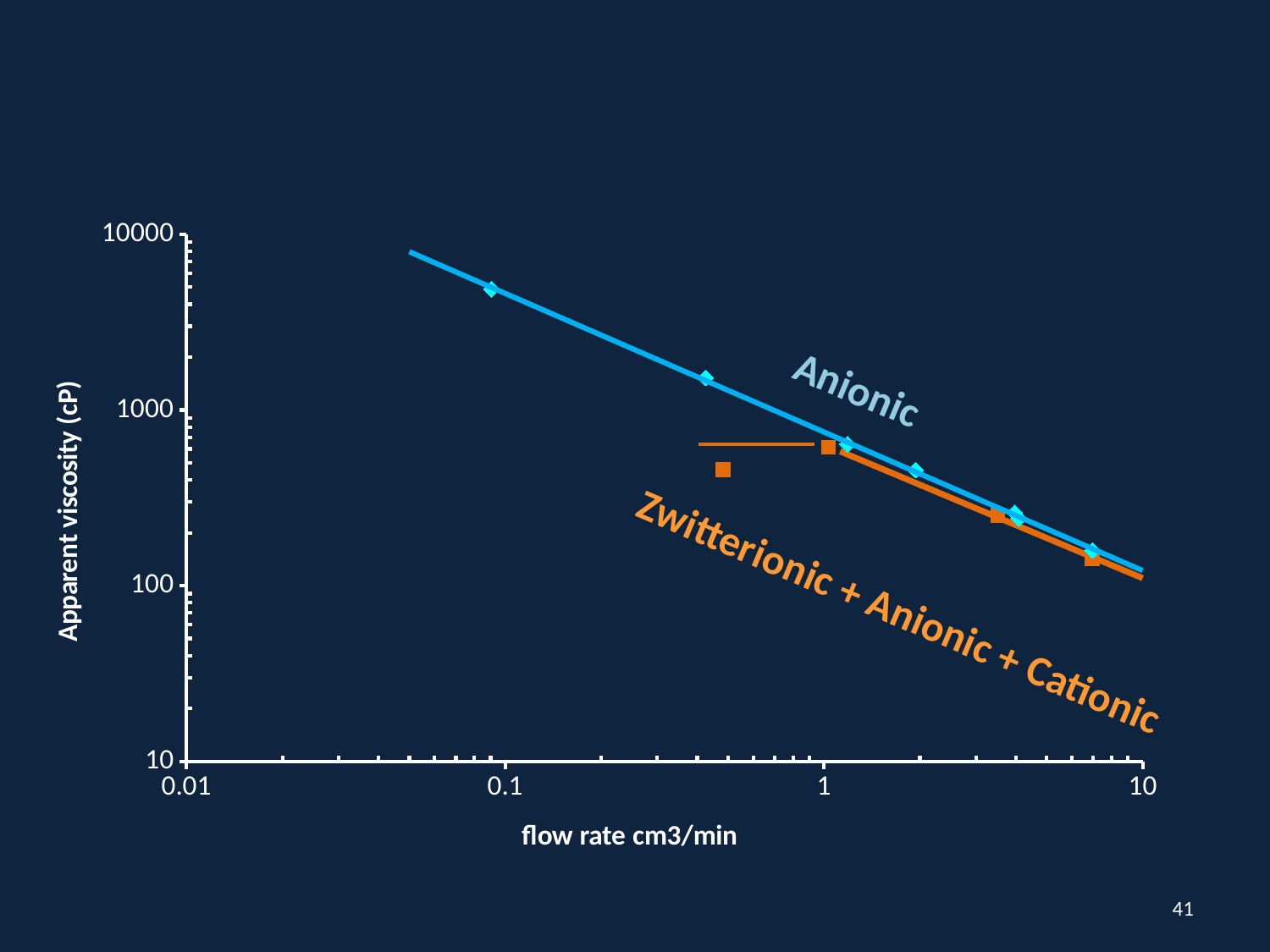
Is the apparent viscosity of the Anionic series at its lowest plotted flow rate (near 0.1 cm3/min) greater or less than 1000 cP? greater Does the apparent viscosity of the Anionic series rise or fall as flow rate increases? Fall How many data points are plotted for the Zwitterionic + Anionic + Cationic series? 4 What kind of chart is shown on the slide? Scatter chart (with trend lines) What is the label of the x axis? flow rate cm3/min Is the apparent viscosity of the Zwitterionic + Anionic + Cationic series at a flow rate of about 0.5 cm3/min greater or less than 1000 cP? less What is the label of the y axis? Apparent viscosity (cP) Is the apparent viscosity of the Anionic series at its highest plotted flow rate (near 10 cm3/min) greater or less than 100 cP? greater Does the apparent viscosity of the Zwitterionic + Anionic + Cationic series rise or fall as flow rate increases from 1 to 10 cm3/min? Fall